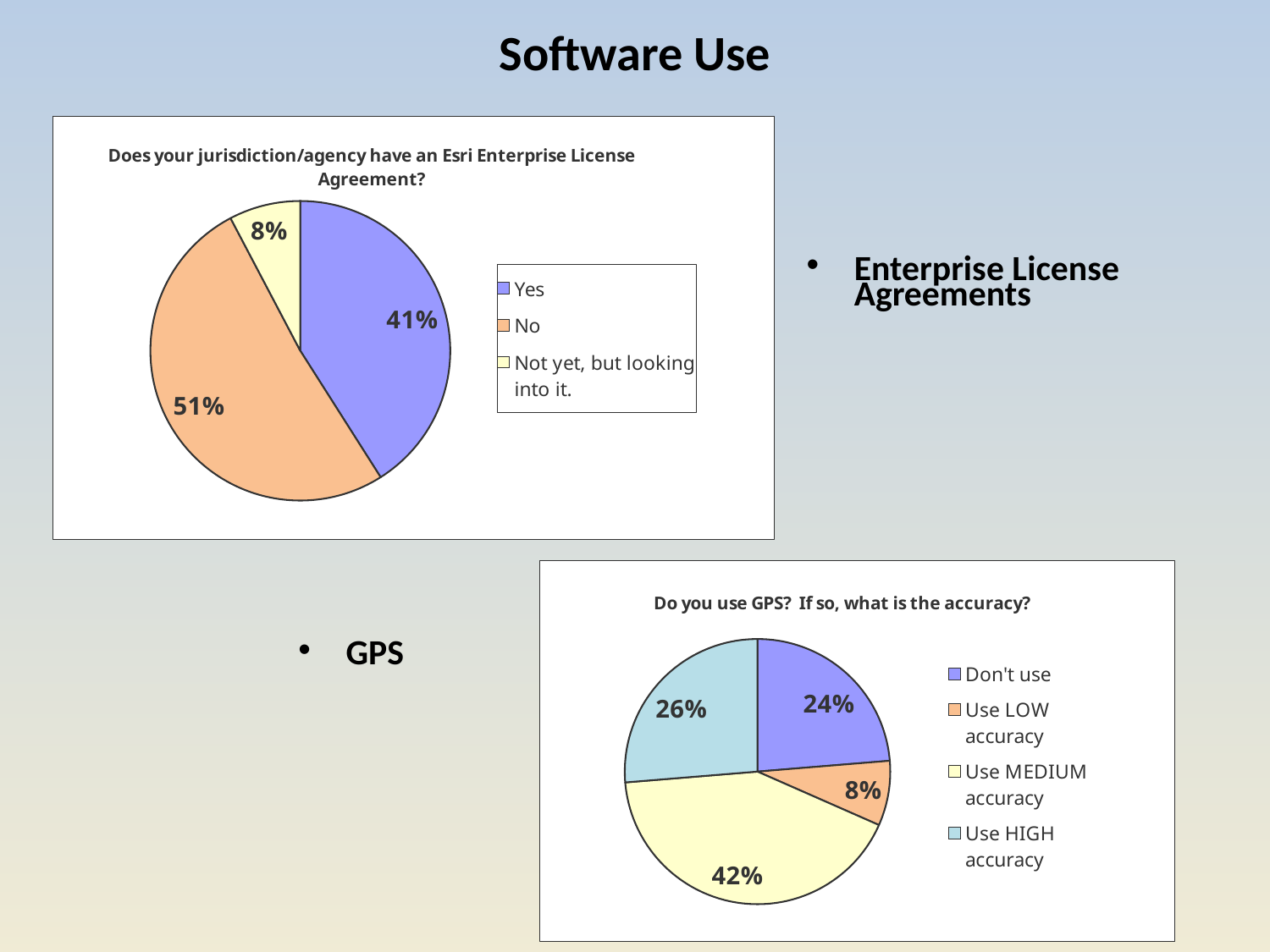
In the chart titled "Does your jurisdiction/agency have an Esri Enterprise License Agreement?", what percentage answered "Yes"? 41% In the chart titled "Does your jurisdiction/agency have an Esri Enterprise License Agreement?", what is the difference between the "No" and "Yes" shares? 10% In the chart titled "Do you use GPS? If so, what is the accuracy?", which is larger: the share using HIGH accuracy or the share that don't use GPS? Use HIGH accuracy In the chart titled "Do you use GPS? If so, what is the accuracy?", which response has the largest share? Use MEDIUM accuracy In the chart titled "Does your jurisdiction/agency have an Esri Enterprise License Agreement?", what percentage answered "No"? 51% In the chart titled "Do you use GPS? If so, what is the accuracy?", what percentage don't use GPS? 24% How many entries does the legend list in the chart titled "Do you use GPS? If so, what is the accuracy?"? 4 What type of chart is the chart titled "Does your jurisdiction/agency have an Esri Enterprise License Agreement?"? Pie chart In the chart titled "Does your jurisdiction/agency have an Esri Enterprise License Agreement?", which response has the smallest share? Not yet, but looking into it. In the chart titled "Do you use GPS? If so, what is the accuracy?", what is the difference between the MEDIUM accuracy share and the LOW accuracy share? 34% In the chart titled "Do you use GPS? If so, what is the accuracy?", what percentage use MEDIUM accuracy? 42% In the chart titled "Does your jurisdiction/agency have an Esri Enterprise License Agreement?", how many slices does the pie have? 3